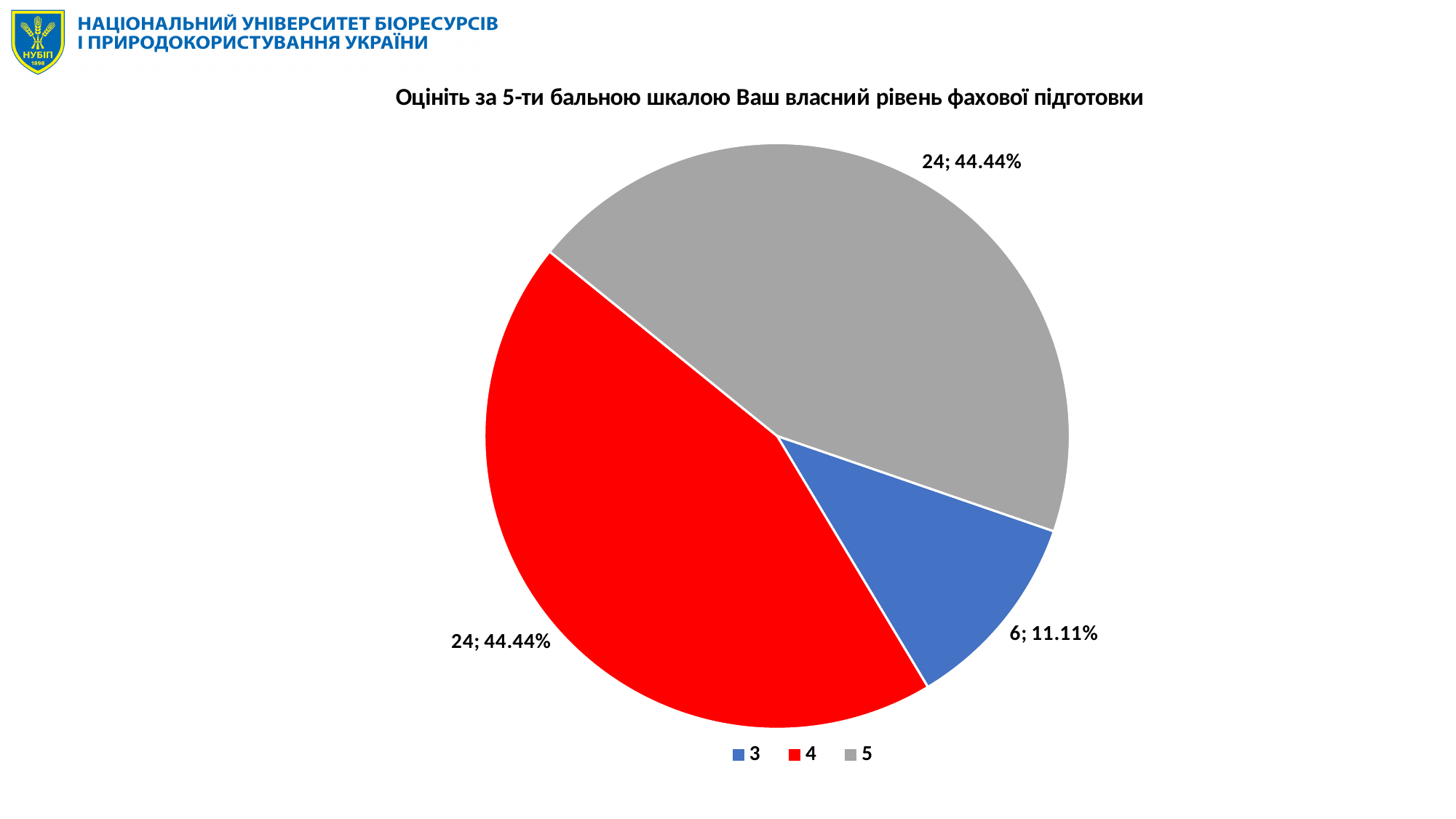
What share of the pie does category 5 represent? 44.44% What is the count for category 3? 6 Which is larger, the value for category 3 or category 4? 4 What is the count for category 5? 24 What share of the pie does category 3 represent? 11.11% How many entries does the legend list? 3 Which category has the smallest slice? 3 What is the count for category 4? 24 What colour is the slice for category 3? blue What is the difference between the values for category 4 and category 3? 18 What kind of chart is shown on the slide? pie chart How many categories does the pie chart have? 3